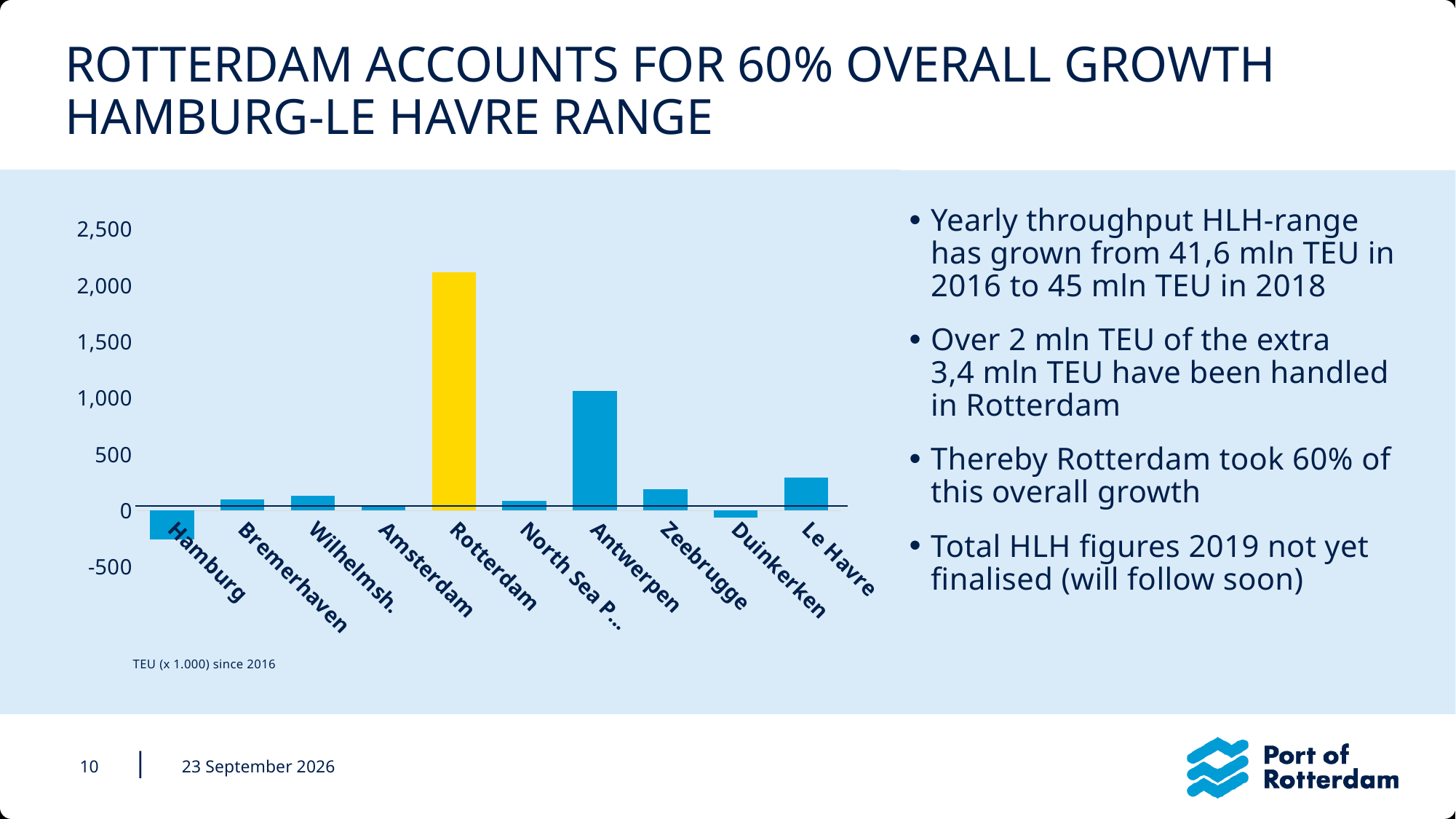
What kind of chart is shown on the slide? bar chart Is the value for Le Havre greater or less than 500? less Which port has the lowest bar in the chart? Hamburg Is the value for Antwerpen greater or less than 1,500? less Is the value for Hamburg greater or less than 0? less How many ports have a negative value in the chart? 2 What colour is the bar for Rotterdam? yellow How many ports are shown on the x axis of the chart? 10 Which is larger, the value for Rotterdam or the value for Antwerpen? Rotterdam Which port has the highest bar in the chart? Rotterdam